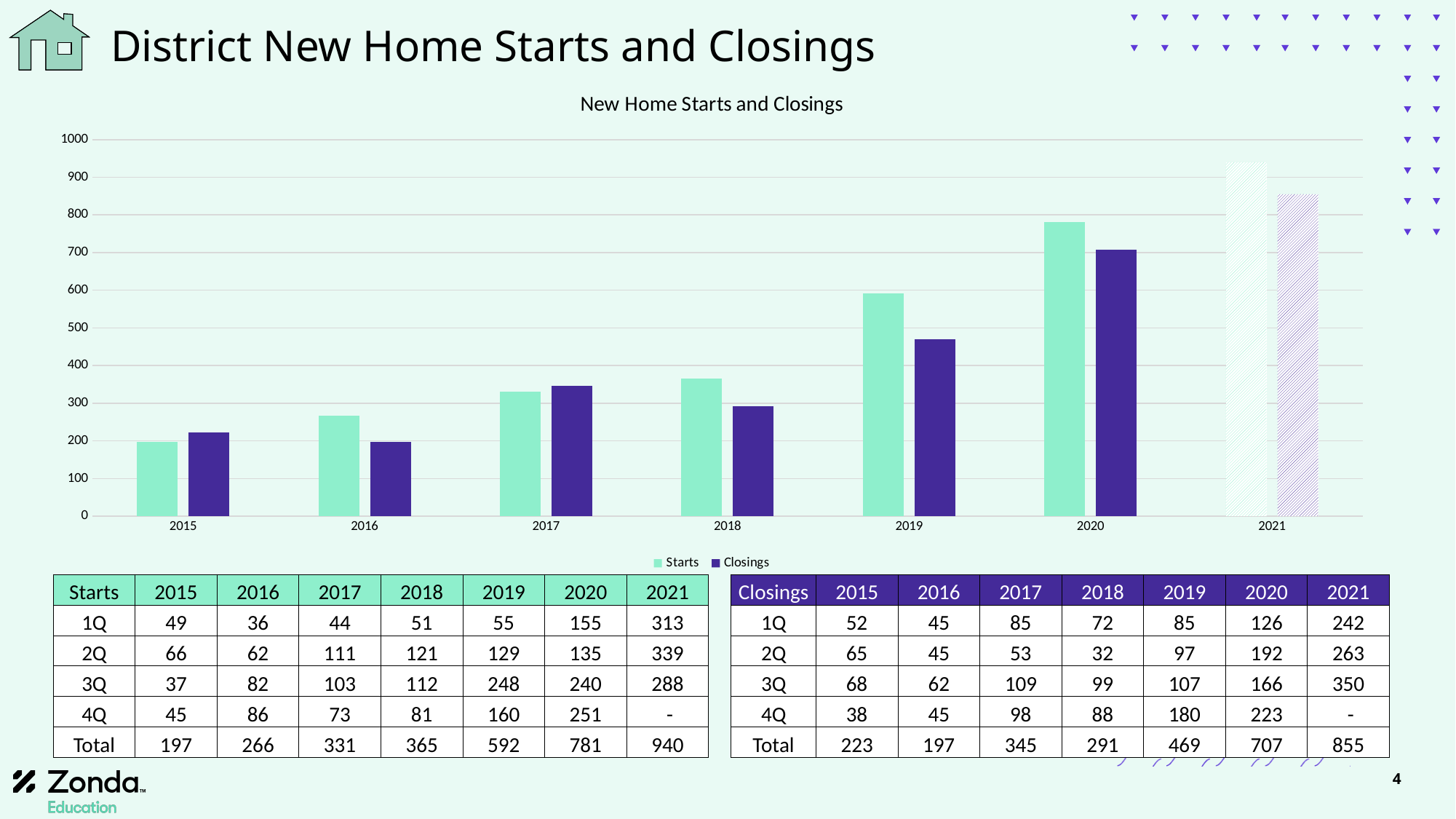
What kind of chart is shown on the slide? bar chart In 2015, which is larger, Starts or Closings? Closings What is the title of the chart? New Home Starts and Closings Which year has the lowest value for Starts? 2015 Do the Starts values generally rise or fall from 2015 to 2021? rise Which year has the highest value for Starts? 2021 How many series does the chart legend list? 2 According to the table, what is the total Closings value for 2020? 707 Is the value for Closings in 2018 greater or less than 300? less How many years are shown on the x axis of the chart? 7 In 2019, which is larger, Starts or Closings? Starts Is the value for Starts in 2020 greater or less than 700? greater